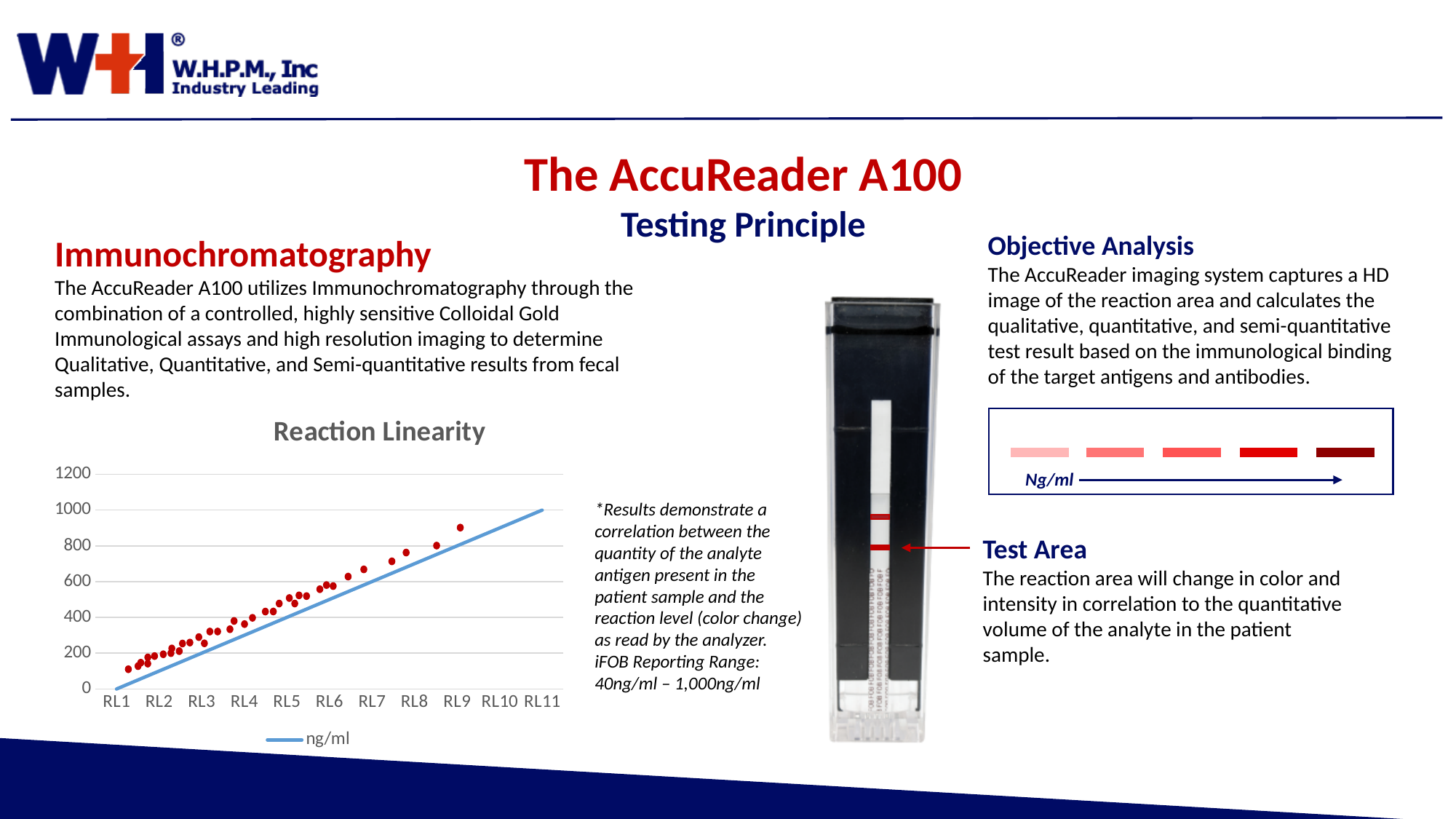
In the Reaction Linearity chart, is the value of the ng/ml line at RL3 greater or less than 400? less What is the title of the chart on the slide? Reaction Linearity In the Reaction Linearity chart, does the ng/ml line rise or fall from RL1 to RL11? rises In the Reaction Linearity chart, is the value of the ng/ml line at RL6 greater or less than 400? greater In the Reaction Linearity chart, what is the value of the ng/ml line at RL11? 1000 How many series does the legend of the Reaction Linearity chart list? 1 What kind of chart is the Reaction Linearity chart? line chart How many categories are shown on the x axis of the Reaction Linearity chart? 11 What series name is shown in the legend of the Reaction Linearity chart? ng/ml In the Reaction Linearity chart, at which category does the ng/ml line reach its highest value? RL11 In the Reaction Linearity chart, at which category is the ng/ml line lowest? RL1 In the Reaction Linearity chart, what is the value of the ng/ml line at RL1? 0